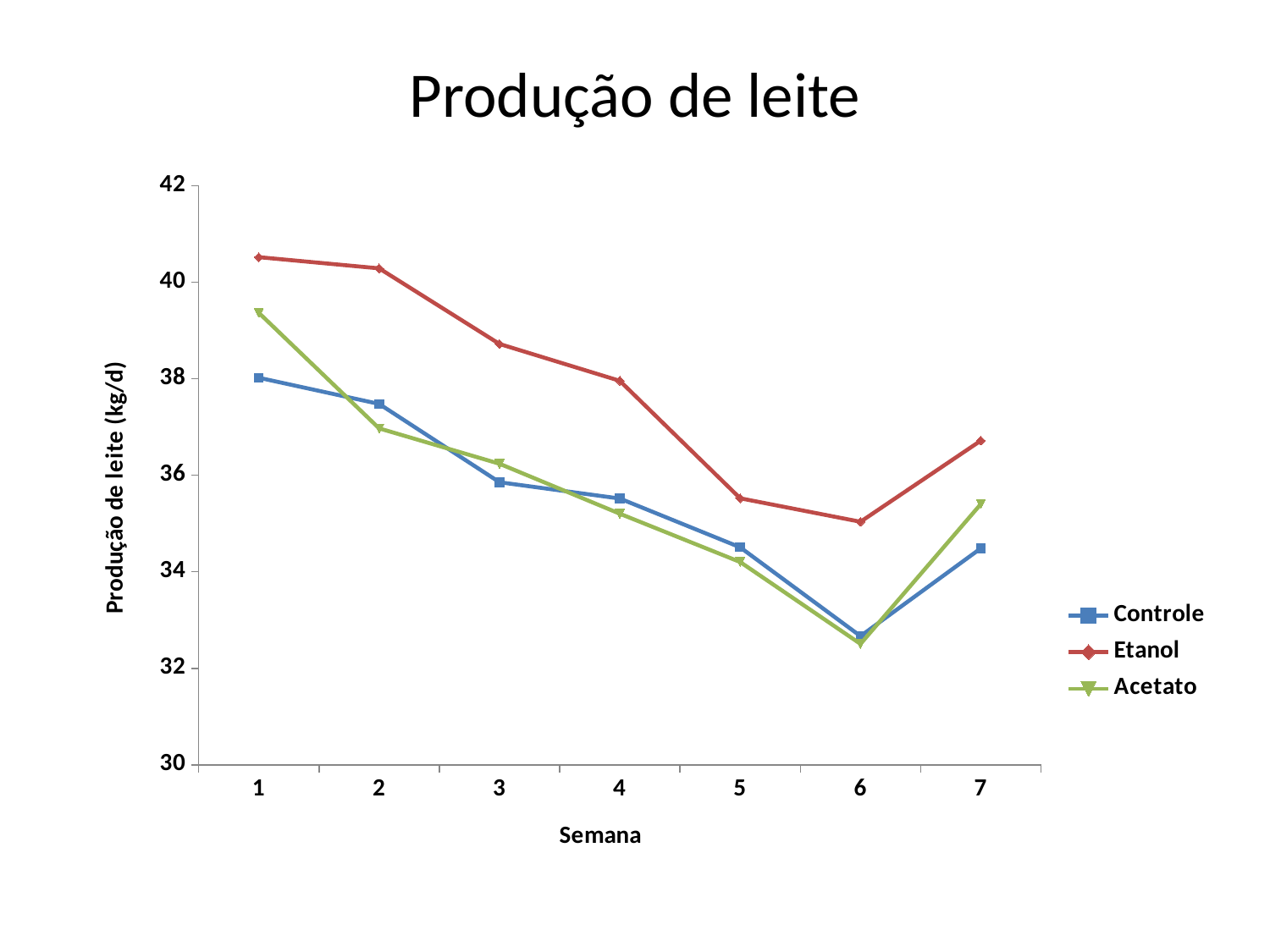
Is the value for Acetato in week 6 greater or less than 34? less In week 4, which series has the larger value, Etanol or Controle? Etanol What is the title of the y axis? Produção de leite (kg/d) Which series has the highest milk production in week 1? Etanol In which week does the Etanol series reach its lowest value? 6 Is the value for Etanol in week 1 greater or less than 40? greater In which week does the Controle series reach its lowest value? 6 How many weeks are plotted along the x axis? 7 Does the Etanol series rise or fall from week 1 to week 6? fall Is the value for Acetato in week 2 greater or less than 38? less How many series does the legend list? 3 What kind of chart is shown on the slide? line chart